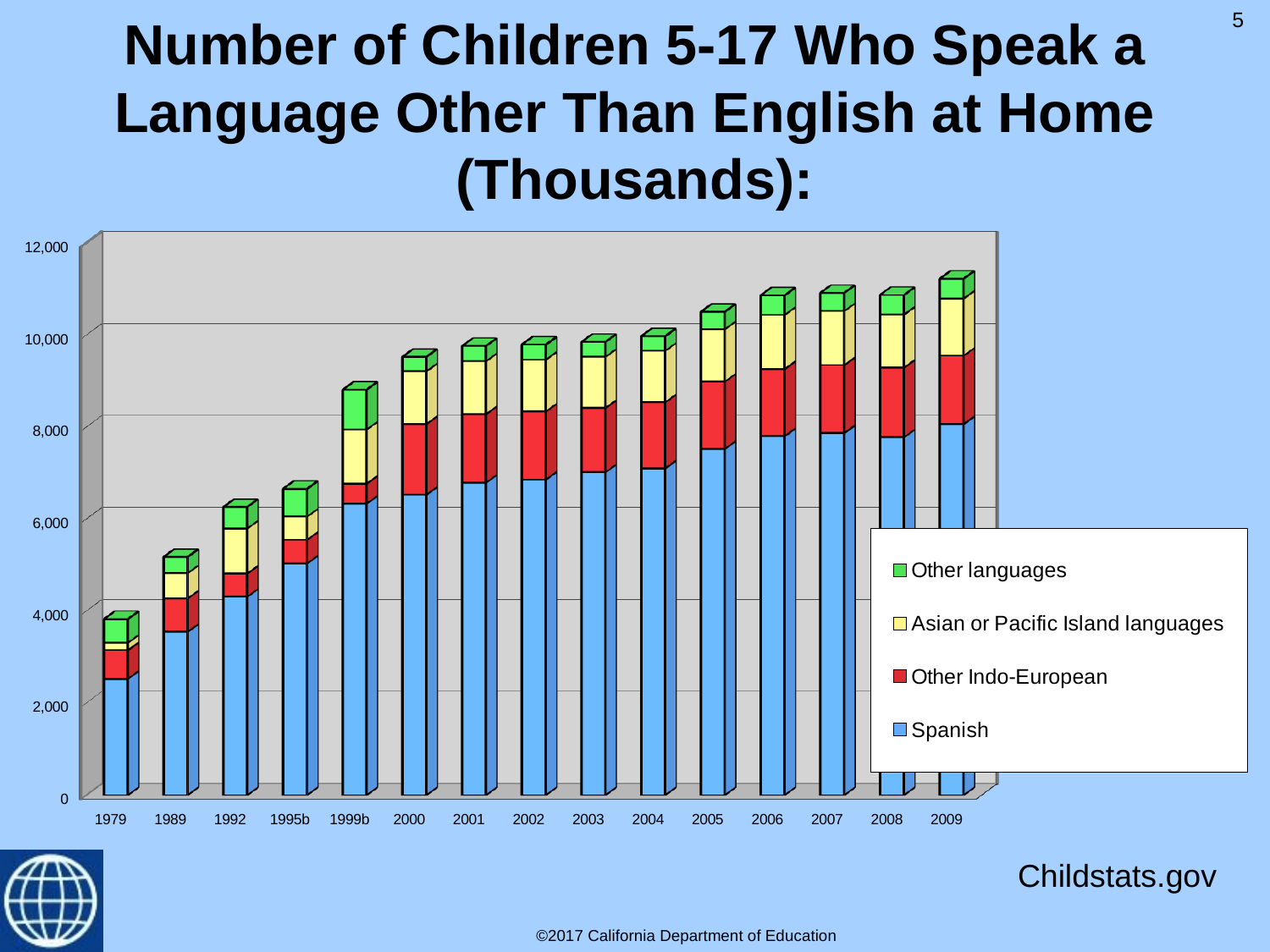
Which series is shown in blue in the legend? Spanish What kind of chart is shown on the slide? Stacked bar chart How many series does the legend list? 4 Which year has the lowest total number of children? 1979 Do the total bar heights generally rise or fall from 1979 to 2009? Rise Which is larger, the Spanish value for 2009 or the Spanish value for 1979? 2009 Which year has the highest total number of children? 2009 How many years (categories) are shown along the x axis? 15 Is the total value for 2009 greater or less than 10,000? greater Is the total value for 1999b greater or less than 8,000? greater